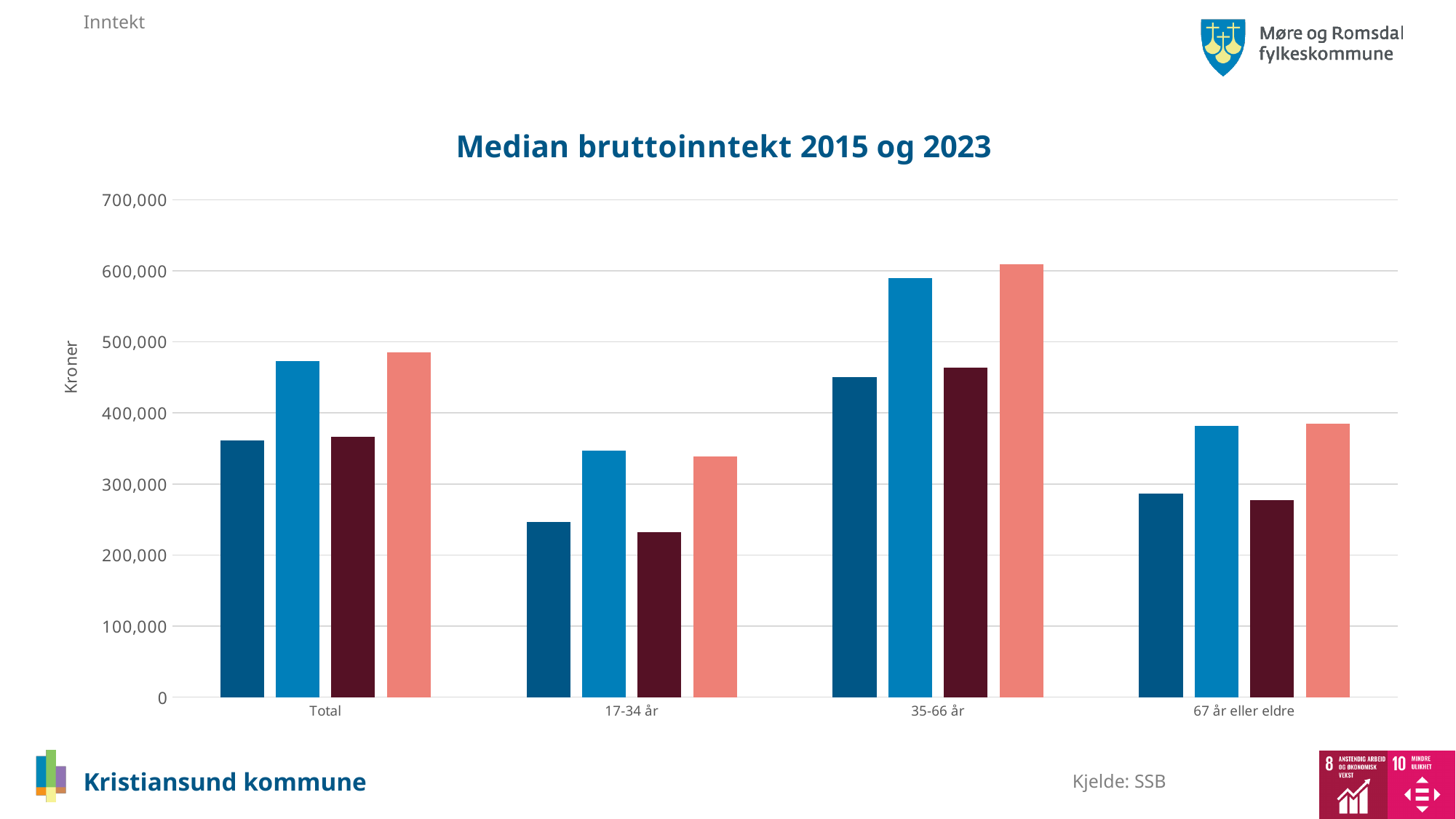
For the Total category, which is taller: the dark blue bar or the light blue bar? the light blue bar Is the value of the dark blue bar for 17-34 år greater or less than 300,000? less How many categories are shown along the x axis of the chart? 4 Which category has the lowest bars on the chart? 17-34 år Is the value of the salmon-coloured bar for Total greater or less than 400,000? greater What is the title of the chart? Median bruttoinntekt 2015 og 2023 What is the label on the vertical axis of the chart? Kroner Is the value of the dark red bar for 67 år eller eldre greater or less than 300,000? less What kind of chart is shown on the slide? bar chart How many bars are plotted for each category on the chart? 4 Which category has the tallest bars on the chart? 35-66 år